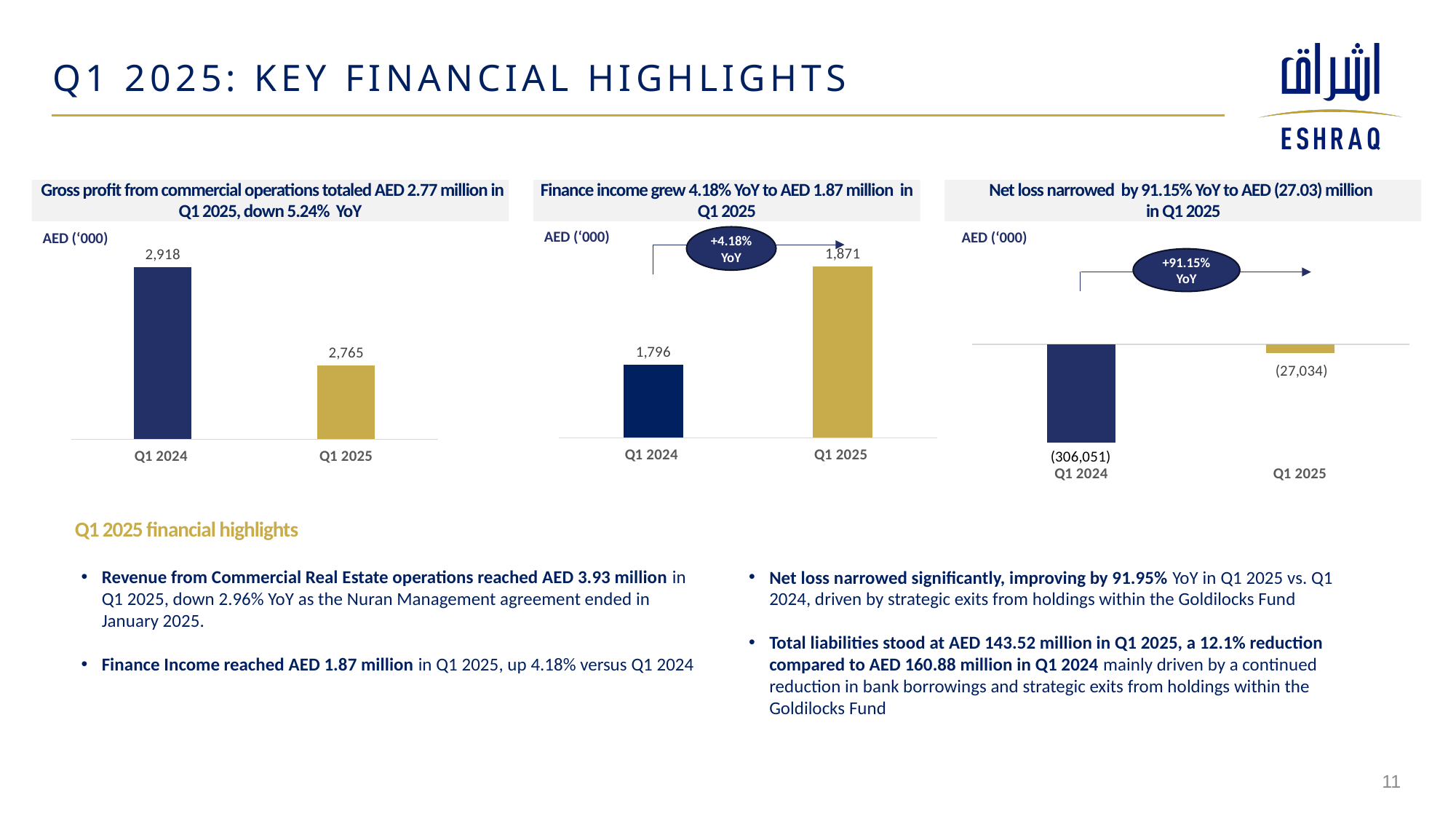
In the middle chart (finance income), which period has the higher value? Q1 2025 What unit is shown above each of the three charts? AED ('000) In the right chart (net loss), what is the value for Q1 2025? (27,034) In the left chart (gross profit from commercial operations), what is the difference between the Q1 2024 and Q1 2025 values? 153 In the left chart (gross profit from commercial operations), what is the value for Q1 2024? 2,918 In the left chart (gross profit from commercial operations), do the values rise or fall from Q1 2024 to Q1 2025? fall In the right chart (net loss), what is the value for Q1 2024? (306,051) In the middle chart (finance income), what is the value for Q1 2024? 1,796 In the left chart (gross profit from commercial operations), what is the value for Q1 2025? 2,765 In the middle chart (finance income), what is the value for Q1 2025? 1,871 In the middle chart (finance income), by how much does the Q1 2025 value exceed the Q1 2024 value? 75 What kind of chart is the middle chart (finance income)? bar chart